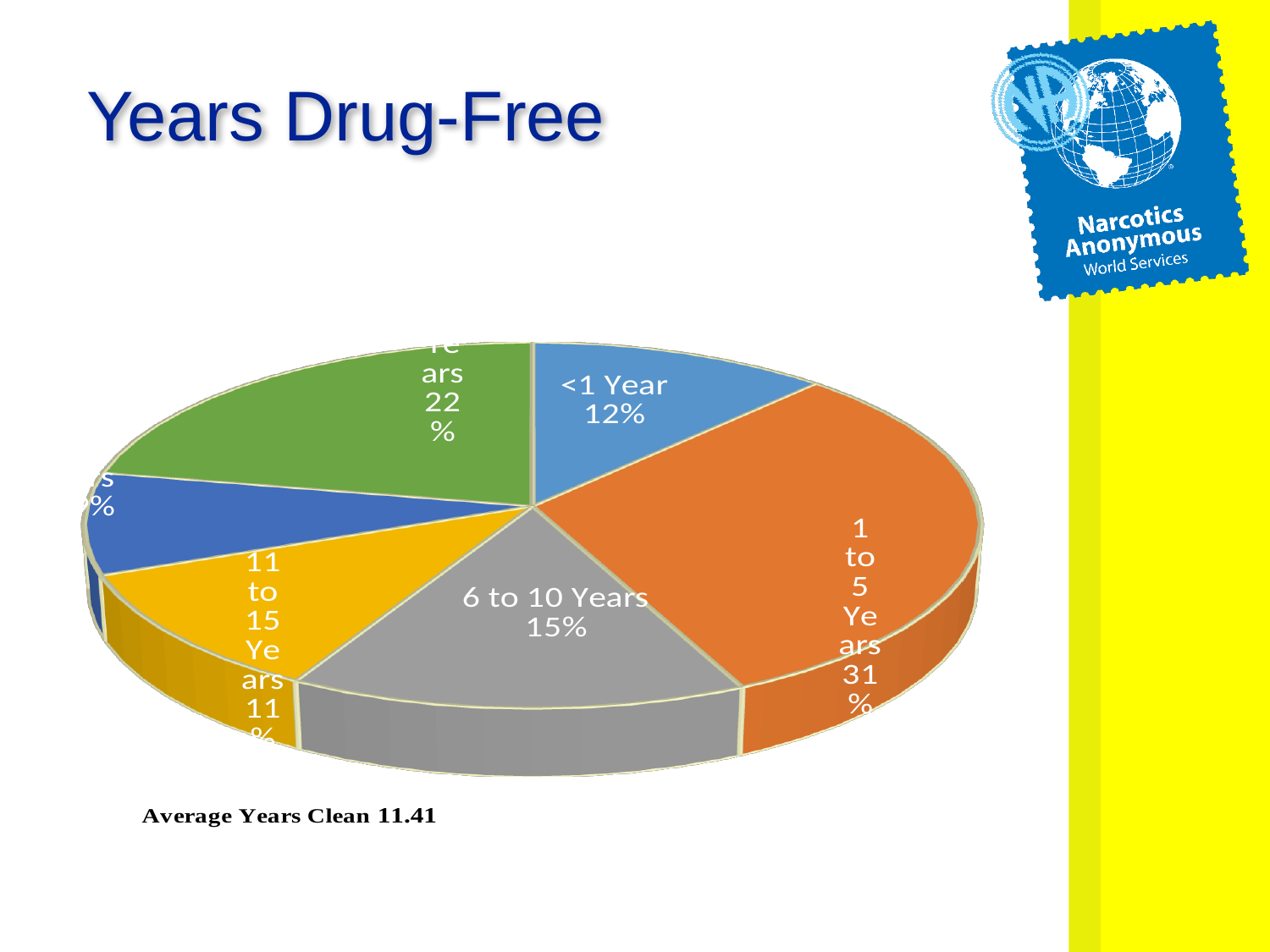
What is the title of the slide containing the chart? Years Drug-Free Which category has the largest slice of the pie? 1 to 5 Years How many percentage points larger is the 1 to 5 Years slice than the <1 Year slice? 19 percentage points What percentage of the pie is the <1 Year slice? 12% Which slice is larger, <1 Year or 6 to 10 Years? 6 to 10 Years What type of chart is shown on the slide? Pie chart How many slices does the pie chart have? 6 What percentage is shown for the 11 to 15 Years slice? 11% How many percentage points larger is the 6 to 10 Years slice than the 11 to 15 Years slice? 4 percentage points What percentage is shown for the 6 to 10 Years slice? 15% Which slice is larger, 1 to 5 Years or 6 to 10 Years? 1 to 5 Years What percentage is shown for the 1 to 5 Years slice? 31%